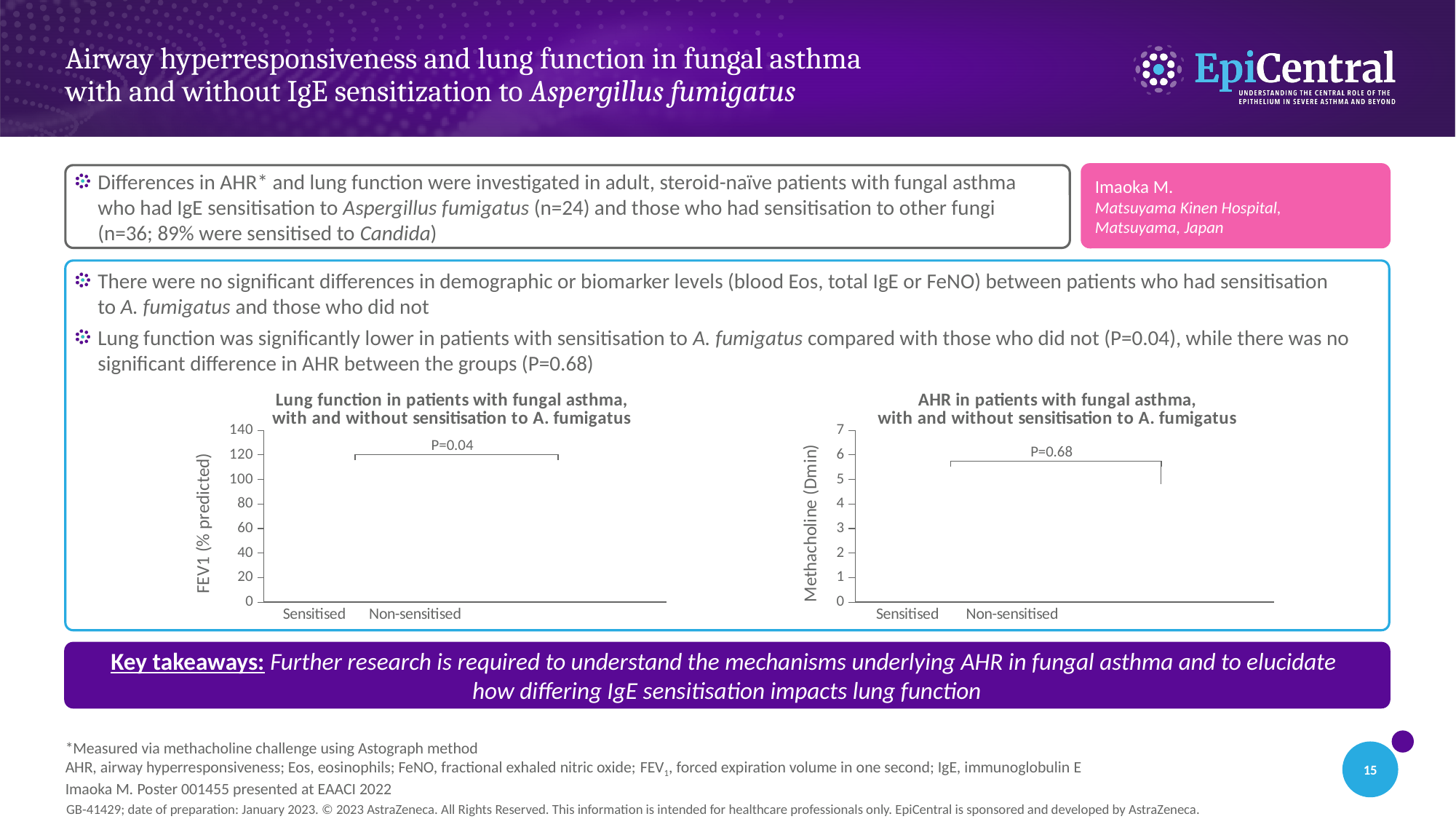
In the left chart (Lung function in patients with fungal asthma), what is the y-axis label? FEV1 (% predicted) In the right chart (AHR in patients with fungal asthma), what P value is printed above the comparison bracket? P=0.68 In the chart titled 'AHR in patients with fungal asthma, with and without sensitisation to A. fumigatus', how many categories are shown on the x axis? 2 In the left chart (Lung function in patients with fungal asthma), what P value is printed above the comparison bracket? P=0.04 In the right chart (AHR in patients with fungal asthma), what is the y-axis label? Methacholine (Dmin) In the chart titled 'Lung function in patients with fungal asthma, with and without sensitisation to A. fumigatus', how many categories are shown on the x axis? 2